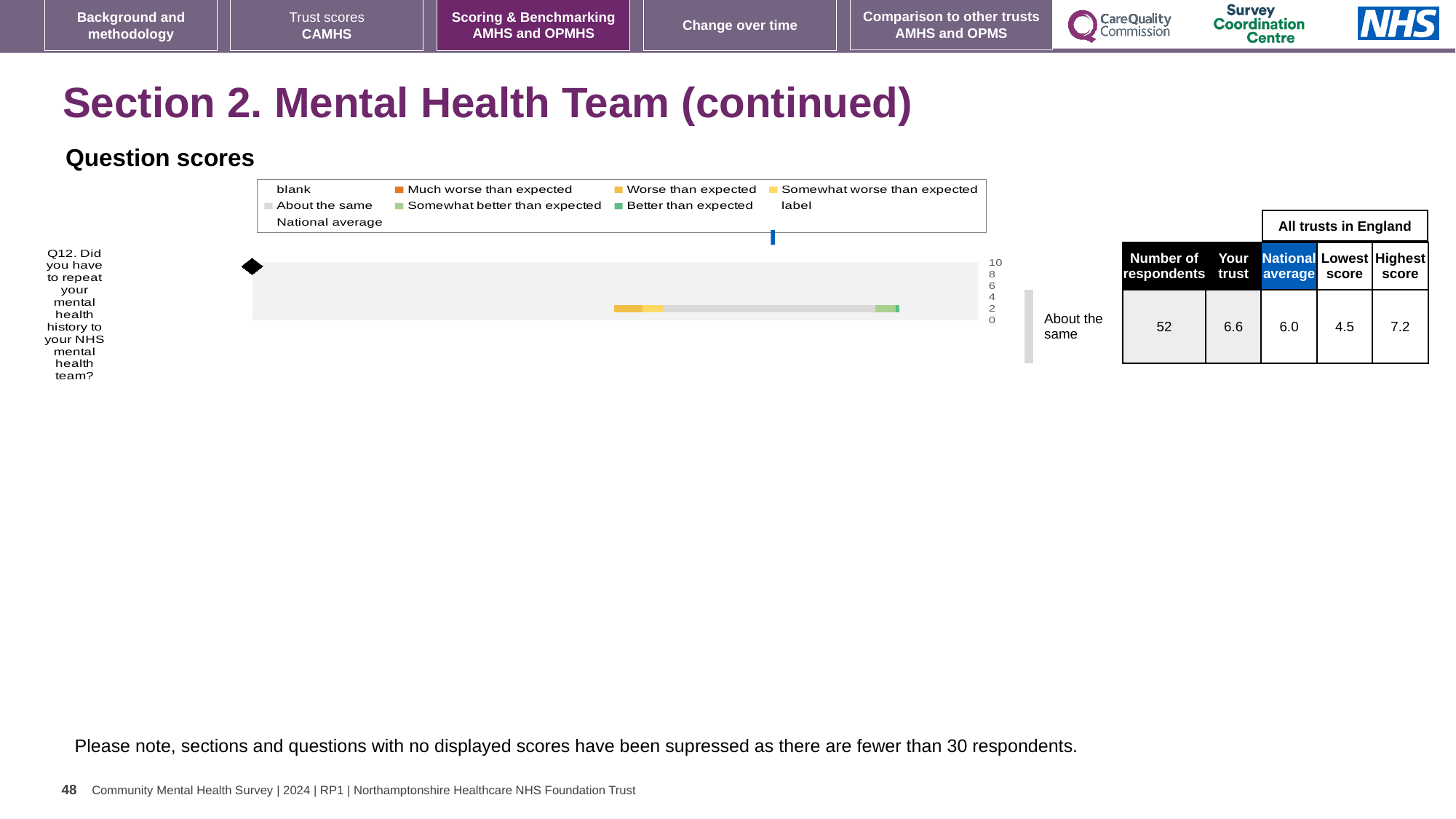
What kind of chart is used to show the Q12 question score? bar chart In the table beside the chart, what is the lowest score among all trusts in England for Q12? 4.5 What is the highest tick value shown on the chart's axis? 10 Is the 'Your trust' score for Q12 larger or smaller than the national average? larger How many questions (categories) are plotted on the chart? 1 Which question is plotted on the chart? Q12. Did you have to repeat your mental health history to your NHS mental health team? In the table beside the chart, what is the number of respondents for Q12? 52 In the table beside the chart, what is the national average score for Q12? 6.0 In the table beside the chart, what is the highest score among all trusts in England for Q12? 7.2 What benchmark category label is shown to the right of the Q12 bar? About the same In the table beside the chart, what is the 'Your trust' score for Q12? 6.6 What is the difference between the highest score and the lowest score for Q12 in the table? 2.7